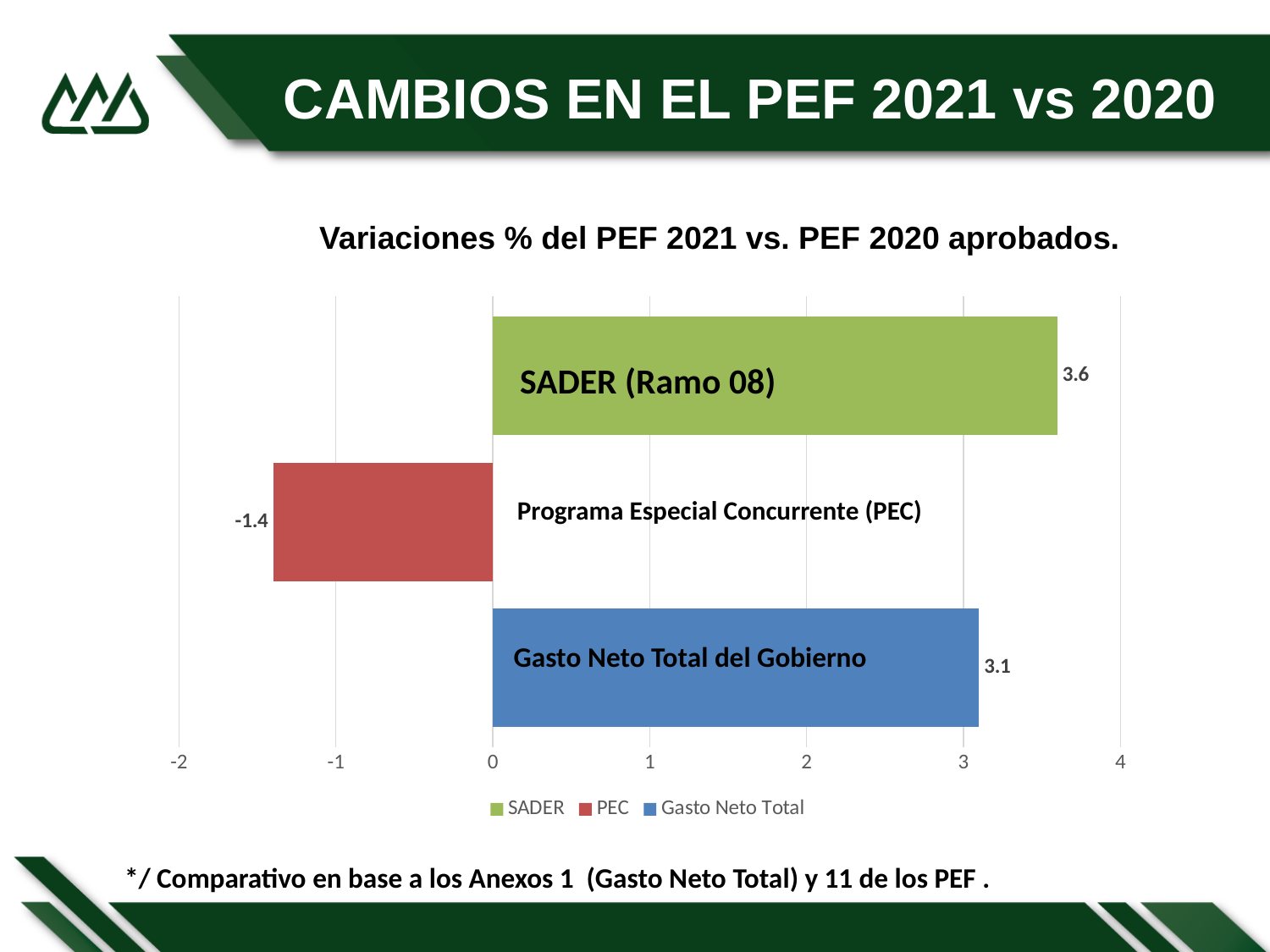
What is the value for SADER (Ramo 08)? 3.6 What is the value for Programa Especial Concurrente (PEC)? -1.4 How many bars are plotted in the chart? 3 What is the title of the chart? Variaciones % del PEF 2021 vs. PEF 2020 aprobados. How many series does the legend list? 3 What is the value for Gasto Neto Total del Gobierno? 3.1 What is the difference between the values for SADER (Ramo 08) and Gasto Neto Total del Gobierno? 0.5 What kind of chart is shown on the slide? Bar chart Which is larger, the value for SADER (Ramo 08) or the value for Gasto Neto Total del Gobierno? SADER (Ramo 08) Is the value for Gasto Neto Total del Gobierno greater or less than 2? greater Which category has the lowest value? Programa Especial Concurrente (PEC) Which category has the highest value? SADER (Ramo 08)